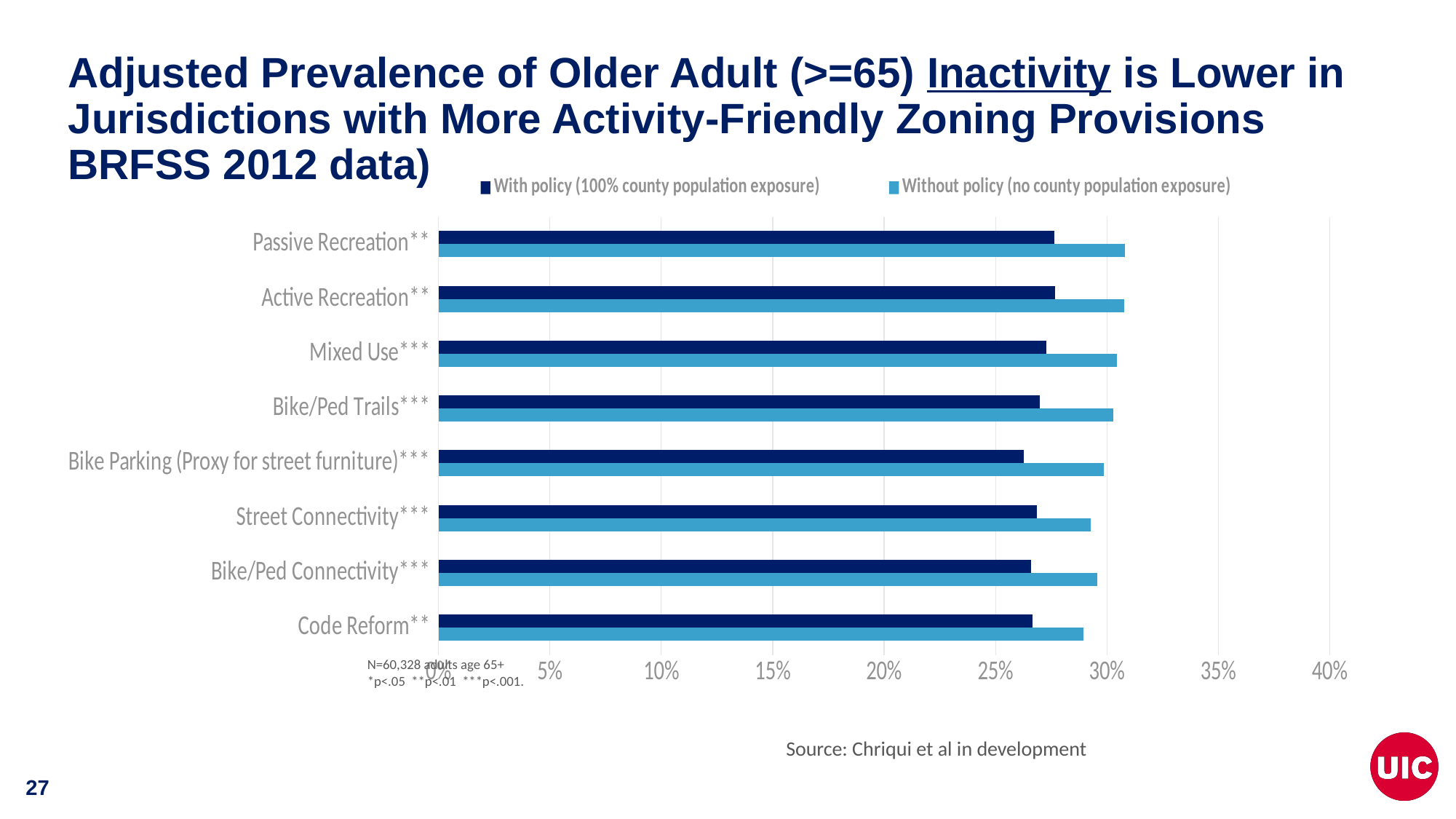
Is the 'With policy' value for Street Connectivity greater or less than 30%? less For Passive Recreation, is the inactivity prevalence higher with policy or without policy? Without policy What kind of chart is shown on the slide? bar chart Is the 'Without policy' value for Code Reform greater or less than 30%? less For Code Reform, which series has the larger value: With policy or Without policy? Without policy How many series does the chart legend list? 2 Is the 'Without policy' value for Mixed Use greater or less than 25%? greater How many zoning provision categories are plotted on the chart? 8 Which series is shown in dark blue? With policy (100% county population exposure) Which series is shown in light blue? Without policy (no county population exposure)